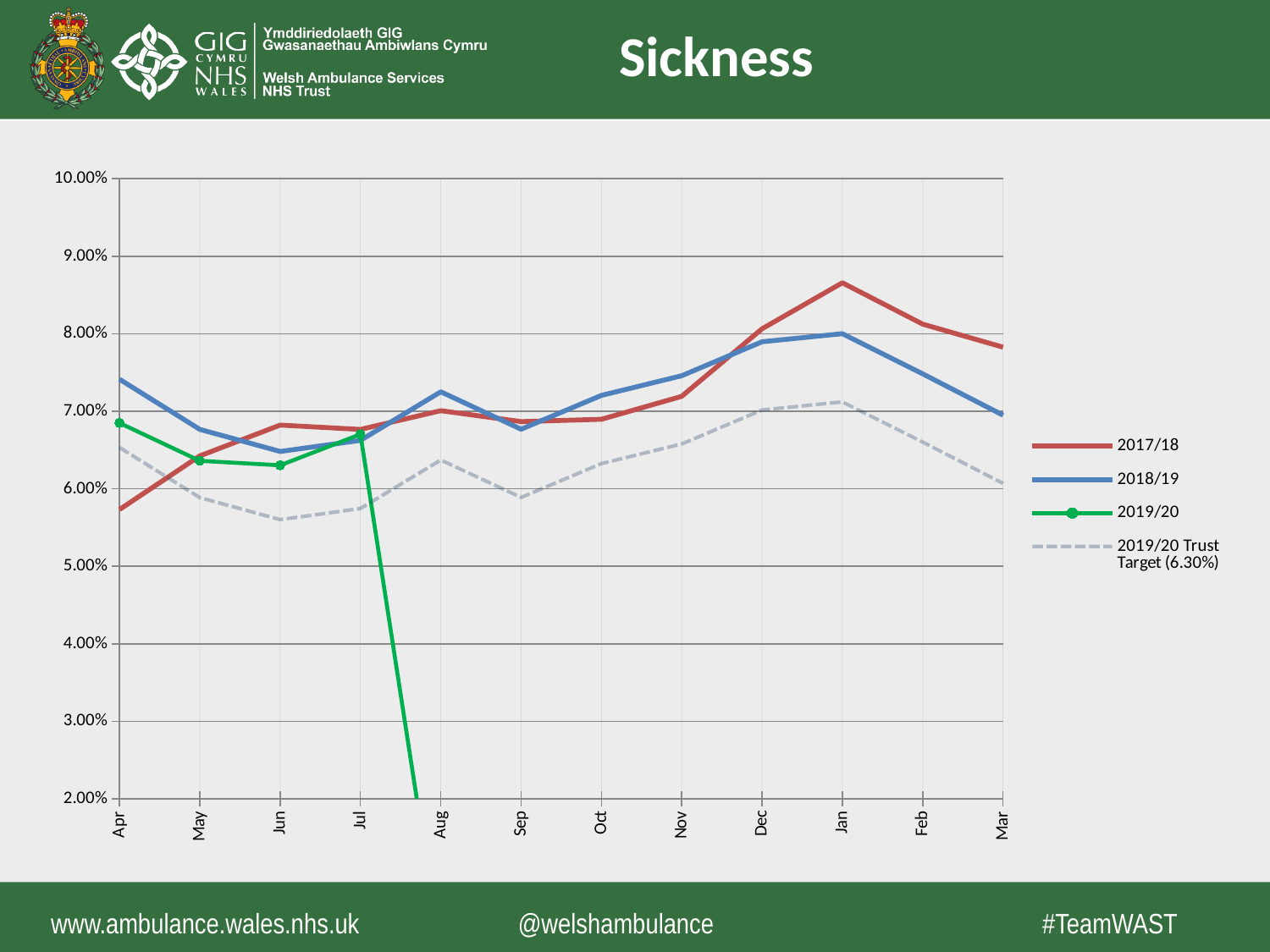
In Jan, which series has the larger value, 2017/18 or 2018/19? 2017/18 Is the value for 2019/20 in May greater or less than 7.00%? less In Apr, which series has the larger value, 2017/18 or 2018/19? 2018/19 Is the value for 2018/19 in Apr greater or less than 7.00%? greater What is the legend label for the dashed grey line? 2019/20 Trust Target (6.30%) Does the 2018/19 series rise or fall from Jan to Mar? fall How many months are shown along the x axis? 12 Is the value for 2017/18 in Jan greater or less than 8.00%? greater In which month does the 2017/18 series reach its highest value? Jan What kind of chart is shown on the slide? line chart How many series does the legend list? 4 In which month does the 2017/18 series have its lowest value? Apr